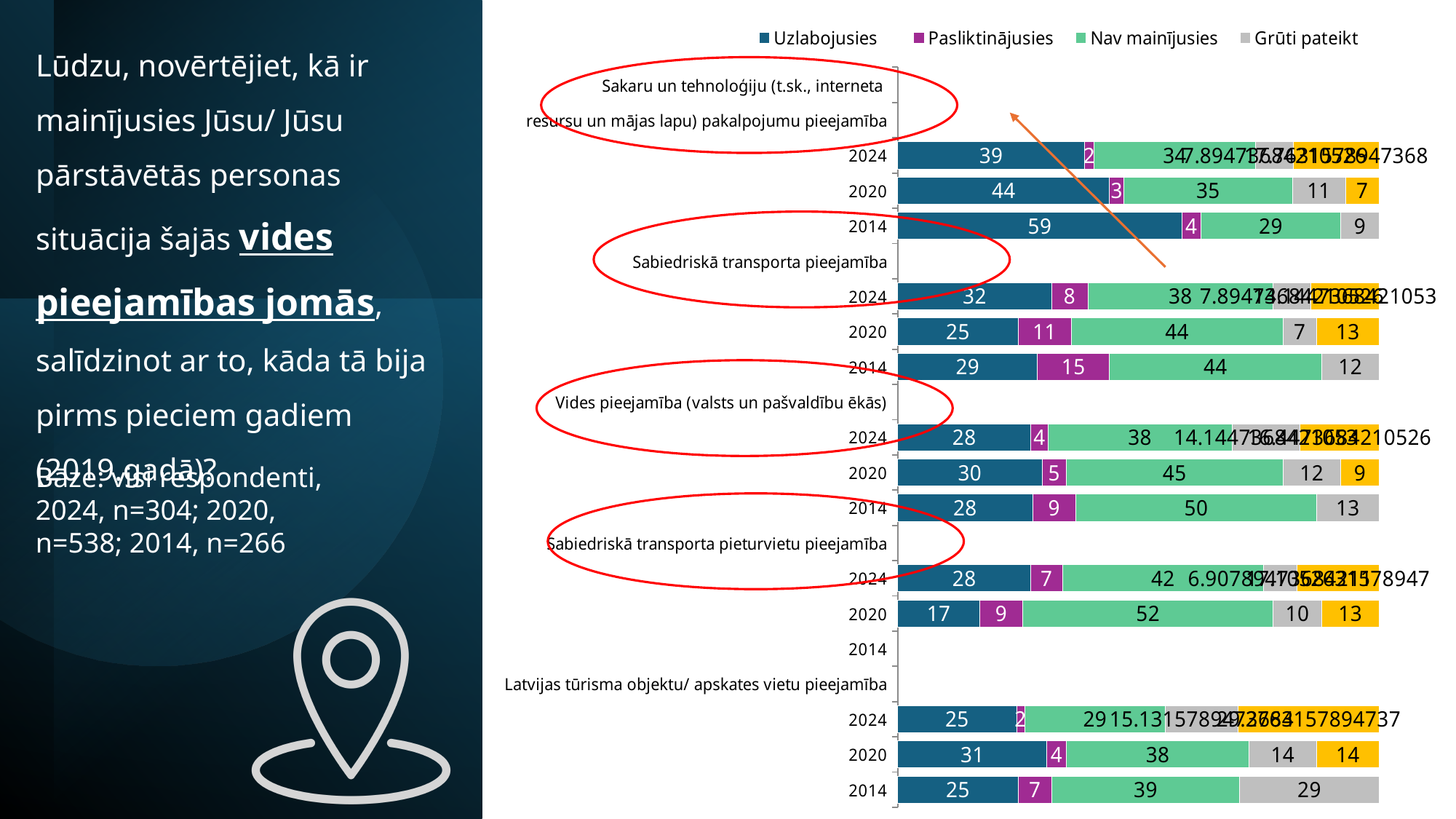
What is the Uzlabojusies value for Sakaru un tehnoloģiju pakalpojumu pieejamība in 2014? 59 What colour represents Pasliktinājusies in the legend? Purple What kind of chart is shown on the slide? Stacked horizontal bar chart What is the Nav mainījusies value for Vides pieejamība (valsts un pašvaldību ēkās) in 2020? 45 What is the Grūti pateikt value for Latvijas tūrisma objektu/ apskates vietu pieejamība in 2014? 29 Among the 2014 bars, which category has the highest Uzlabojusies value? Sakaru un tehnoloģiju (t.sk., interneta resursu un mājas lapu) pakalpojumu pieejamība What is the Nav mainījusies value for Sabiedriskā transporta pieturvietu pieejamība in 2020? 52 What is the Uzlabojusies value for Sabiedriskā transporta pieejamība in 2014? 29 By how much does the Uzlabojusies value for Sakaru un tehnoloģiju pakalpojumu pieejamība in 2014 exceed the 2020 value? 15 For Sabiedriskā transporta pieejamība, which year has the larger Pasliktinājusies value, 2014 or 2020? 2014 How many series does the chart legend list? 4 What is the Pasliktinājusies value for Sabiedriskā transporta pieejamība in 2020? 11